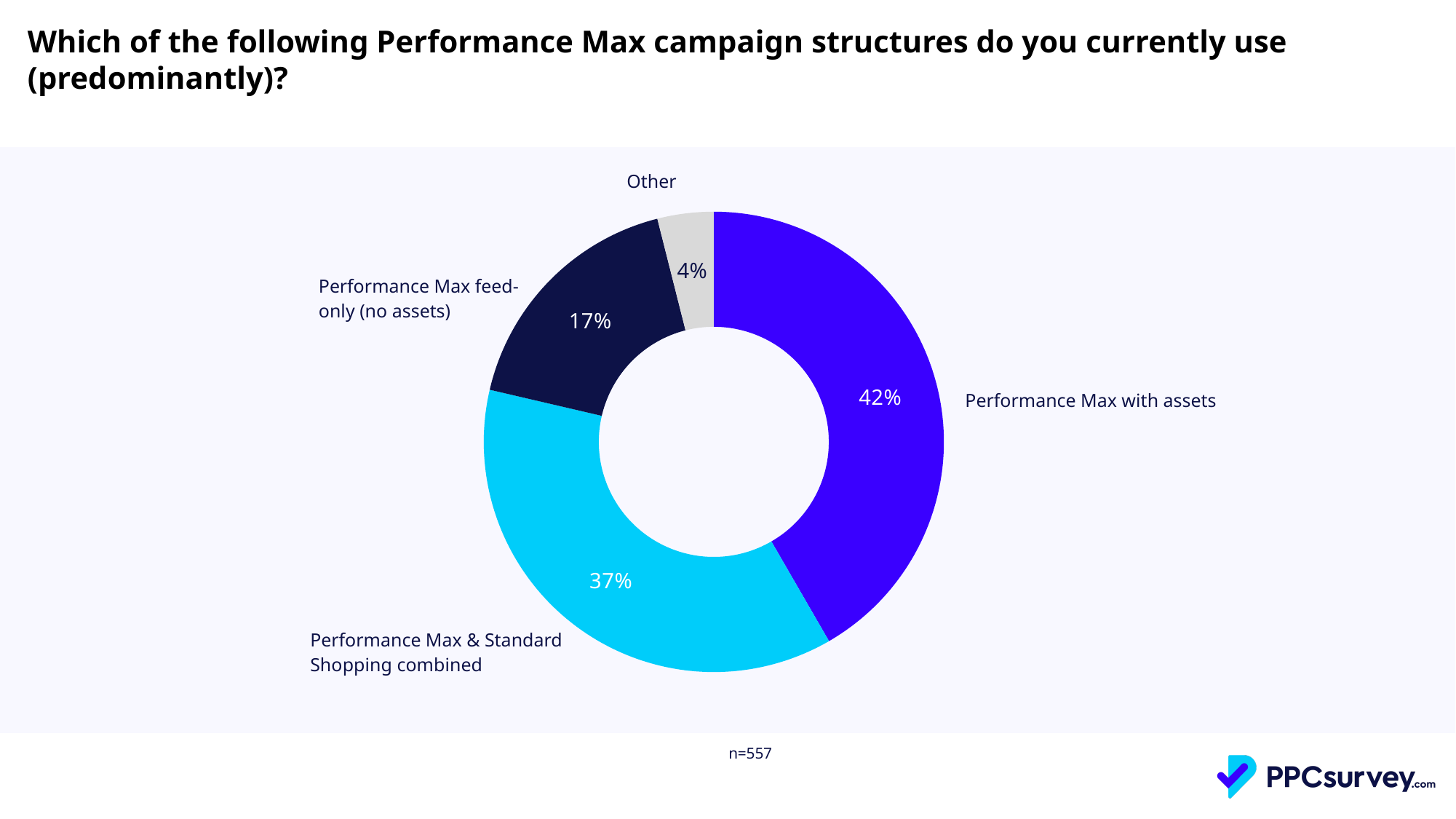
Which is larger: Performance Max feed-only (no assets) or Performance Max & Standard Shopping combined? Performance Max & Standard Shopping combined How many categories are shown in the chart? 4 What is the difference in percentage points between Performance Max feed-only (no assets) and Other? 13 Which campaign structure has the largest share? Performance Max with assets What percentage of respondents use Performance Max & Standard Shopping combined? 37% What is the sample size (n) shown below the chart? n=557 What percentage of respondents chose Other? 4% What kind of chart is shown on the slide? Pie chart (donut) What percentage of respondents use Performance Max with assets? 42% What percentage of respondents use Performance Max feed-only (no assets)? 17% What is the difference in percentage points between Performance Max with assets and Performance Max & Standard Shopping combined? 5 Which category has the smallest share? Other